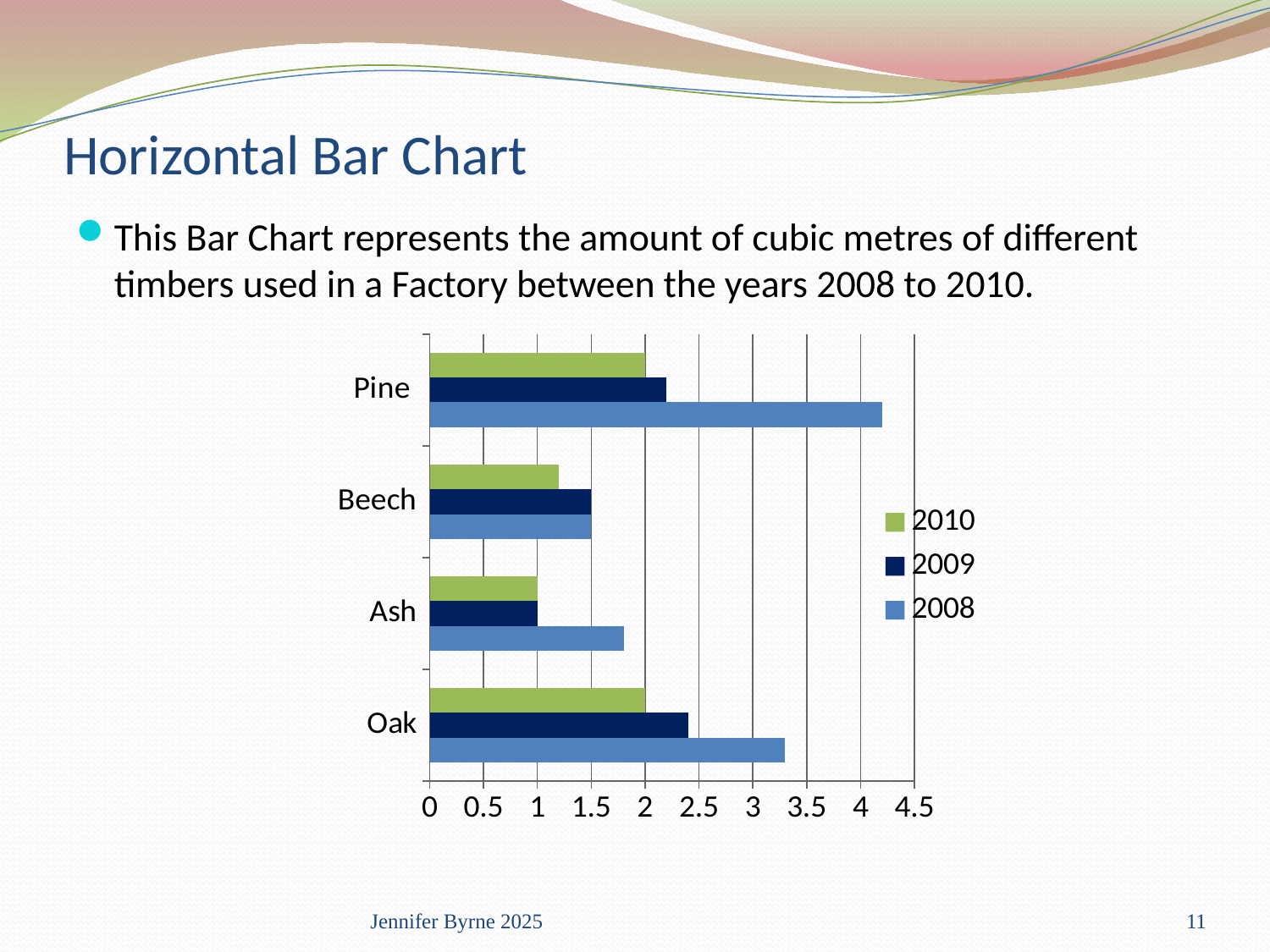
Is the value for Oak in 2008 greater or less than 3? greater Which years are listed in the chart's legend? 2010, 2009, 2008 Which timber has the lowest value for 2008? Beech What kind of chart is shown on the slide? bar chart Which is larger, the 2008 value for Pine or the 2008 value for Oak? Pine How many series does the legend list? 3 Which timber has the highest value for 2009? Oak Which is larger, the 2009 value for Oak or the 2009 value for Beech? Oak Which timber has the highest value for 2008? Pine Is the value for Pine in 2008 greater or less than 4? greater How many timber categories are shown on the chart? 4 Is the value for Ash in 2008 greater or less than 2? less